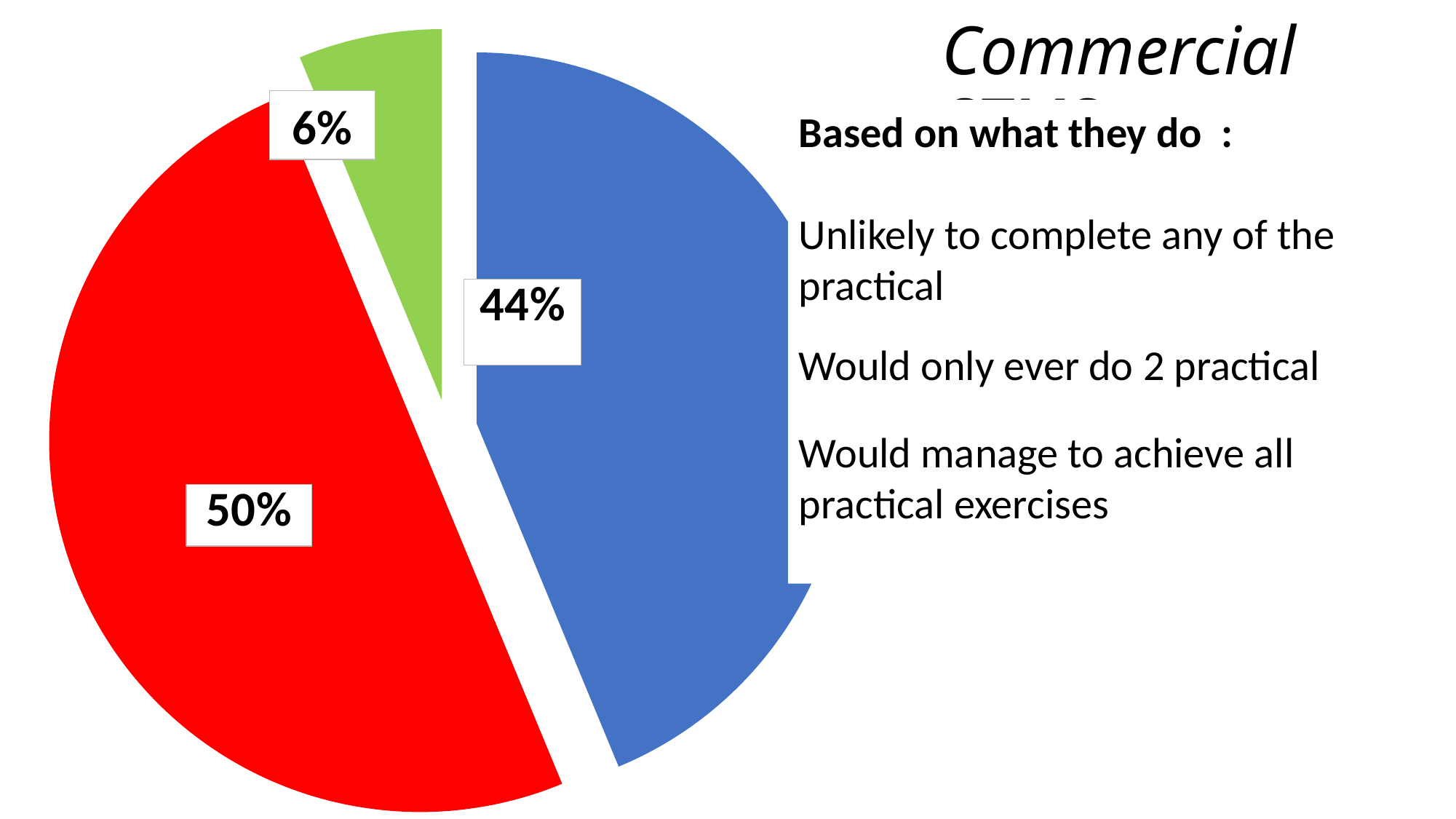
What percentage is shown on the green slice of the pie chart? 6% What percentage is shown on the blue slice of the pie chart? 44% What is the difference in percentage points between the red slice and the blue slice? 6 What kind of chart is shown on the slide? pie chart Which slice is larger, the red slice or the blue slice? red What colour is the largest slice of the pie chart? red What is the value of the smallest slice of the pie chart? 6% What is the value of the largest slice of the pie chart? 50% What do the three slice percentages add up to? 100% What percentage is shown on the red slice of the pie chart? 50% What is the difference in percentage points between the blue slice and the green slice? 38 How many slices does the pie chart have? 3